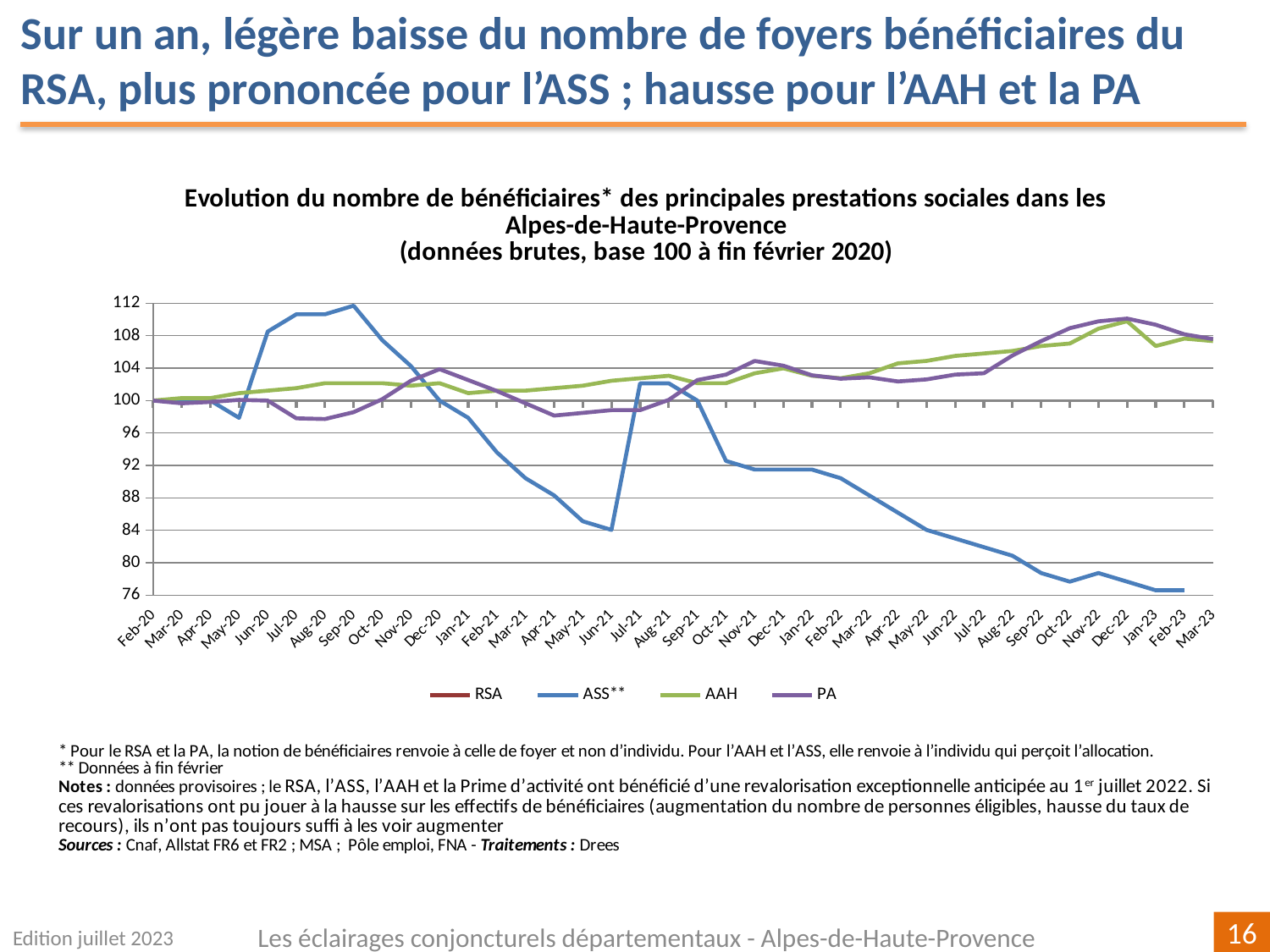
What kind of chart is shown on the slide? line chart Is the value for AAH in Mar-23 greater or less than 104? greater What is the base period for the index (base 100) according to the chart title? fin février 2020 Which series are listed in the legend? RSA, ASS**, AAH, PA Does the ASS** line rise or fall between Sep-21 and Mar-23? fall Is the value for PA in Dec-22 greater or less than 108? greater Is the value for ASS** in Sep-20 greater or less than 108? greater How many series does the legend list? 4